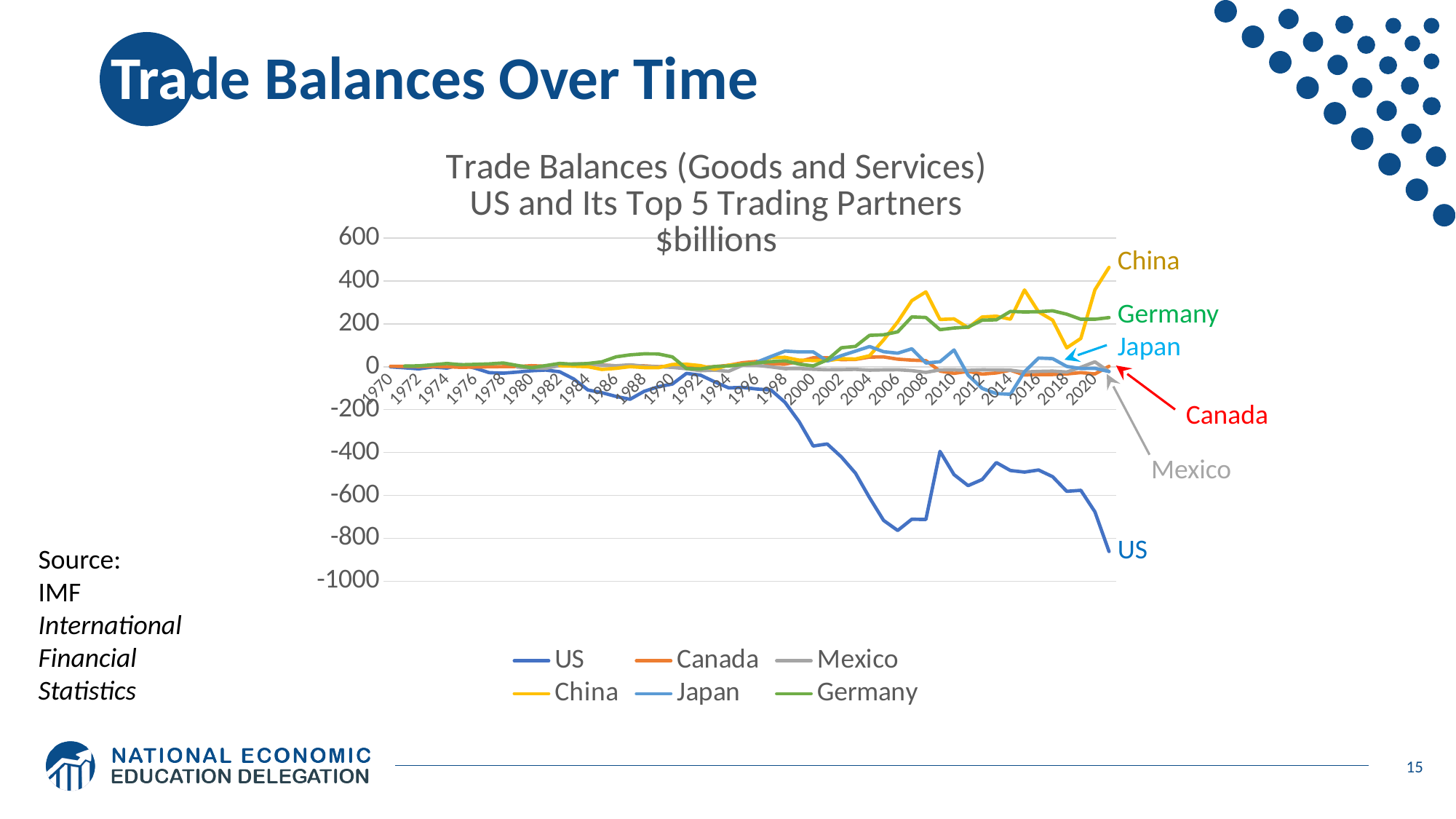
Does the US trade balance rise or fall between 1998 and 2006? fall In 2020, which is larger, the value for China or the value for Germany? China Is the value for the US in 2006 greater or less than -600? less Is the value for the US in 2020 greater or less than -800? greater How many series does the legend list? 6 In what units are the values on the chart expressed, according to the chart title? $billions What kind of chart is shown on the slide? line chart Does China's trade balance rise or fall between 2000 and 2008? rise Which series has the highest value in 2020? China Is the value for Germany in 2020 greater or less than 200? greater Which series has the lowest value in 2020? US